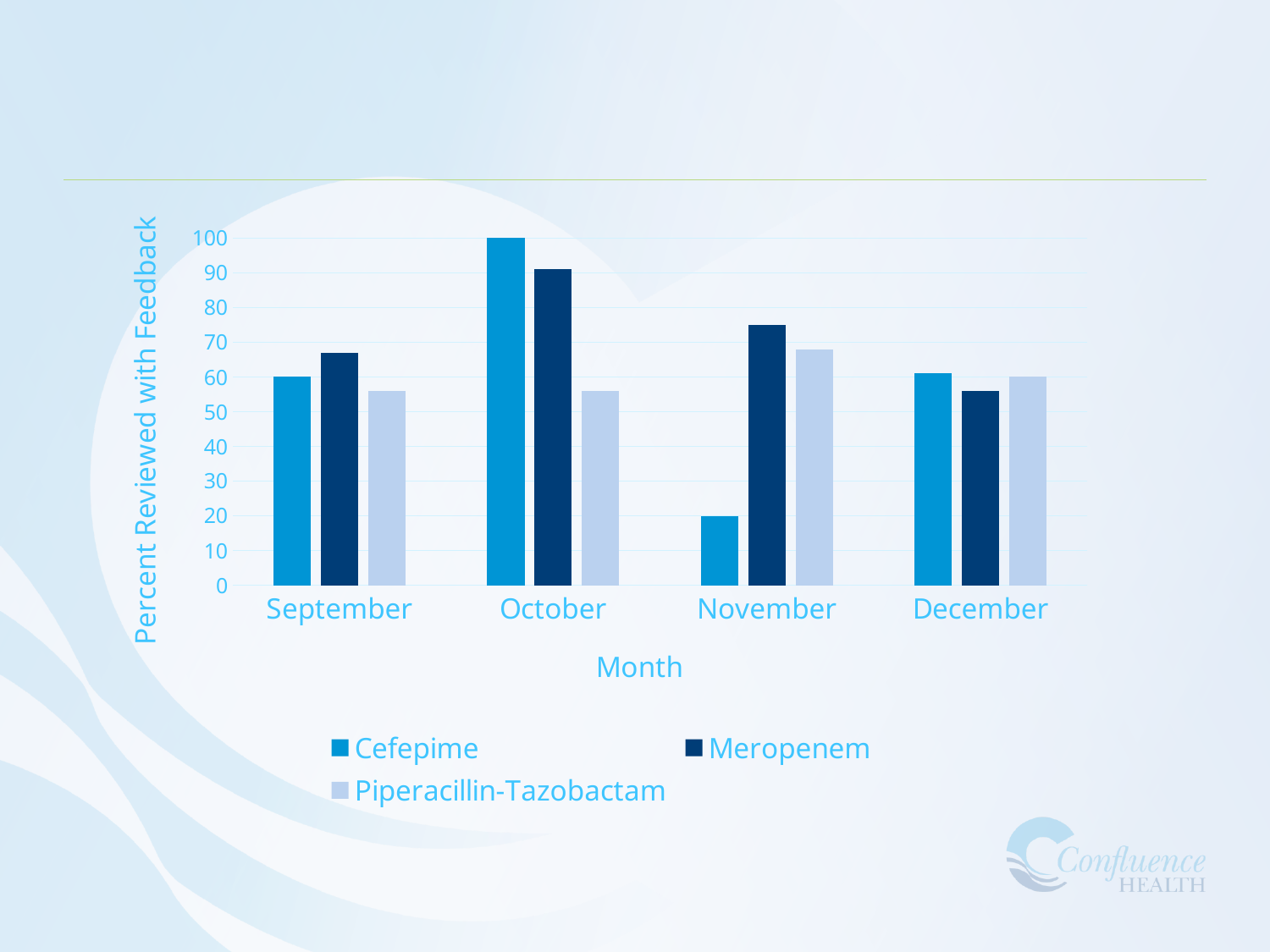
What is the value for Cefepime in October? 100 In which month is the Cefepime value highest? October Is the value for Meropenem in October greater or less than 80? greater What kind of chart is shown on the slide? bar chart How many series does the legend list? 3 What is the value for Cefepime in November? 20 Is the value for Piperacillin-Tazobactam in September greater or less than 60? less How many months are shown on the x axis? 4 Is the value for Meropenem in November greater or less than 70? greater In November, which is larger: the value for Meropenem or the value for Cefepime? Meropenem What is the title of the y axis? Percent Reviewed with Feedback In which month is the Cefepime value lowest? November